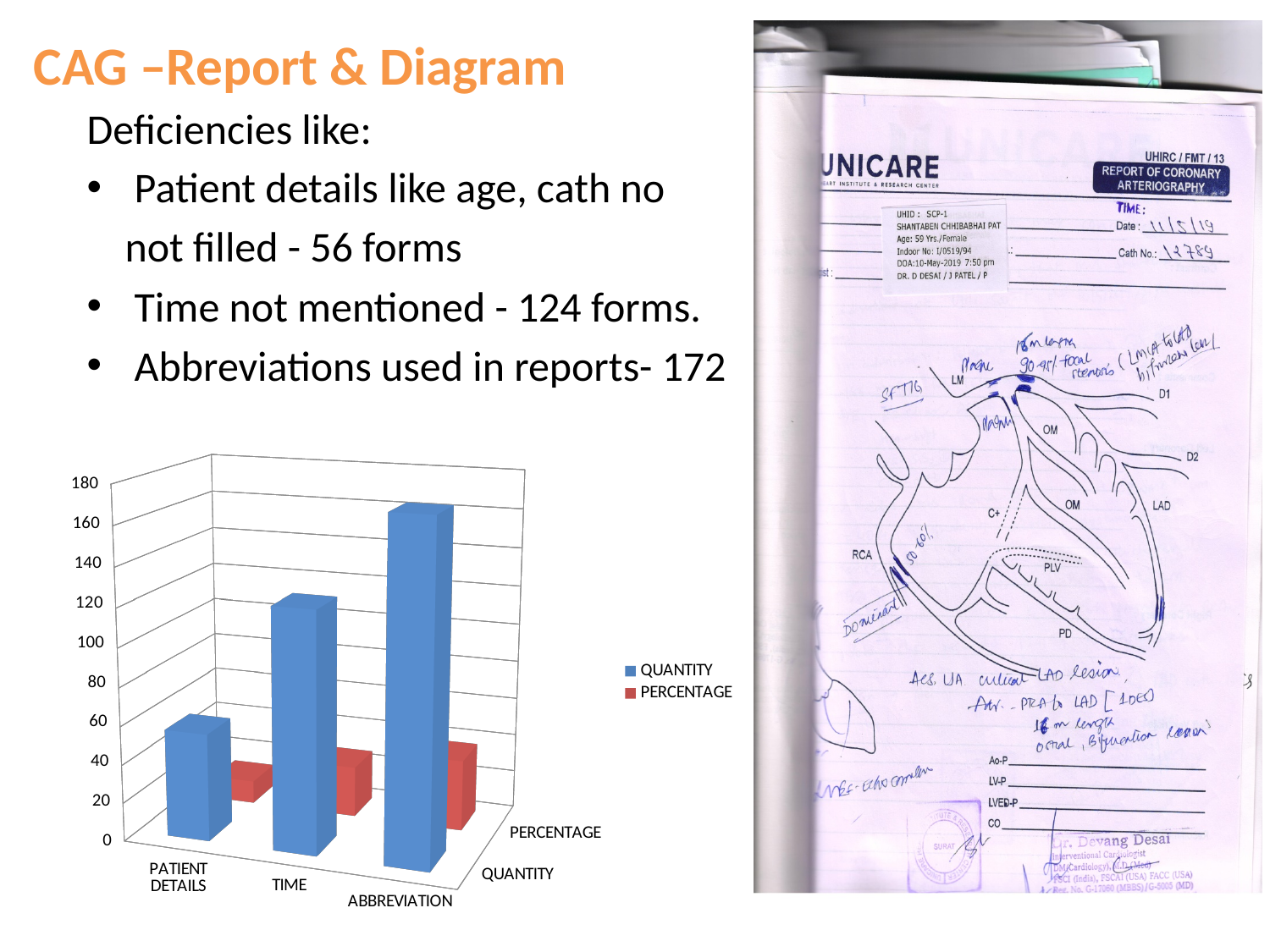
Do the QUANTITY values rise or fall from PATIENT DETAILS to ABBREVIATION along the x axis? rise What kind of chart is shown on the slide? bar chart Is the QUANTITY value for ABBREVIATION greater or less than 140? greater Which colour represents the QUANTITY series in the chart's legend? blue How many categories are shown on the chart's x axis? 3 Which category has the highest QUANTITY value? ABBREVIATION Is the PERCENTAGE value for ABBREVIATION greater or less than 60? less Which has the larger QUANTITY value, TIME or PATIENT DETAILS? TIME Which category has the lowest QUANTITY value? PATIENT DETAILS How many series does the chart's legend list? 2 Is the QUANTITY value for PATIENT DETAILS greater or less than 80? less